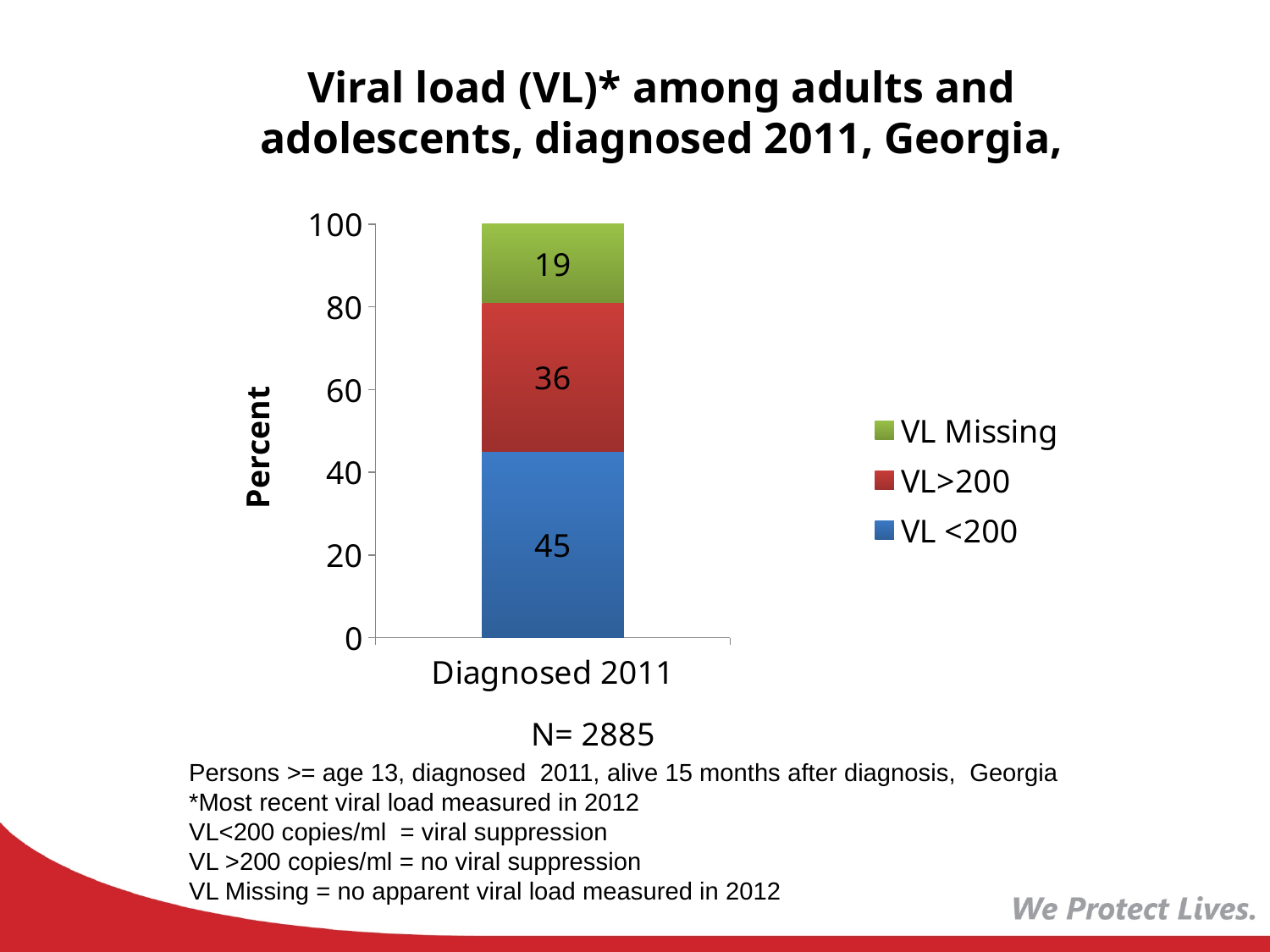
What kind of chart is shown on the slide? Stacked bar chart Which series has the largest segment in the Diagnosed 2011 bar? VL <200 What is the difference between the VL <200 and VL>200 values? 9 What is the value for VL <200 in the Diagnosed 2011 bar? 45 How many series does the legend list? 3 What is the value for VL Missing in the Diagnosed 2011 bar? 19 Which series has the smallest segment in the Diagnosed 2011 bar? VL Missing What is the label of the y axis? Percent What is the total of the stacked Diagnosed 2011 bar? 100 How many categories are shown on the x axis? 1 Which is larger, the VL>200 value or the VL Missing value? VL>200 What is the value for VL>200 in the Diagnosed 2011 bar? 36